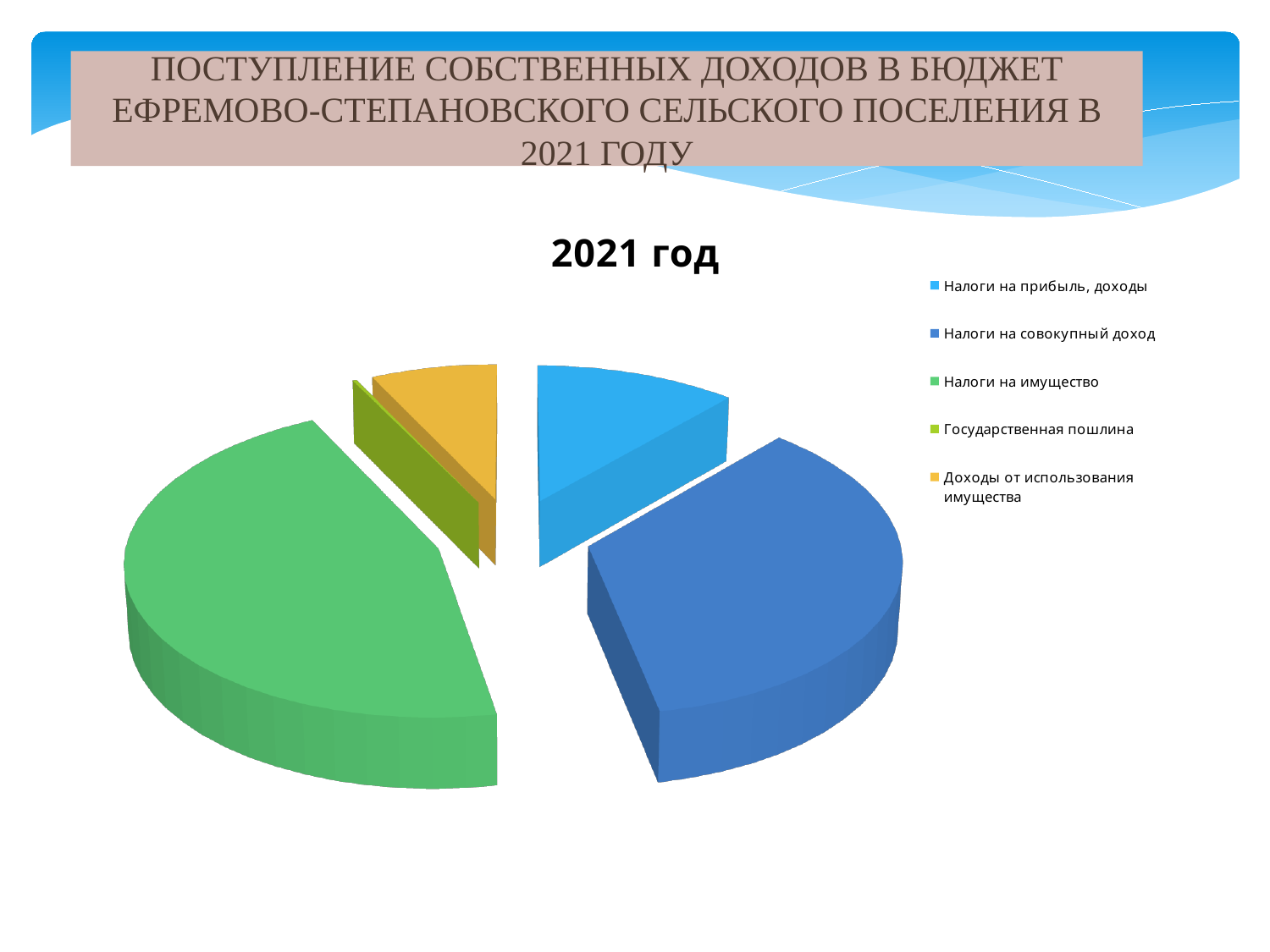
Which slice is larger: Доходы от использования имущества or Государственная пошлина? Доходы от использования имущества How many categories does the legend of the pie chart list? 5 Which slice is larger: Налоги на совокупный доход or Налоги на прибыль, доходы? Налоги на совокупный доход Which category has the largest slice of the pie? Налоги на имущество Which slice is larger: Налоги на имущество or Налоги на совокупный доход? Налоги на имущество What colour is the slice for Налоги на имущество? green Which category has the smallest slice of the pie? Государственная пошлина What kind of chart is shown on the slide? pie chart What is the title of the chart? 2021 год